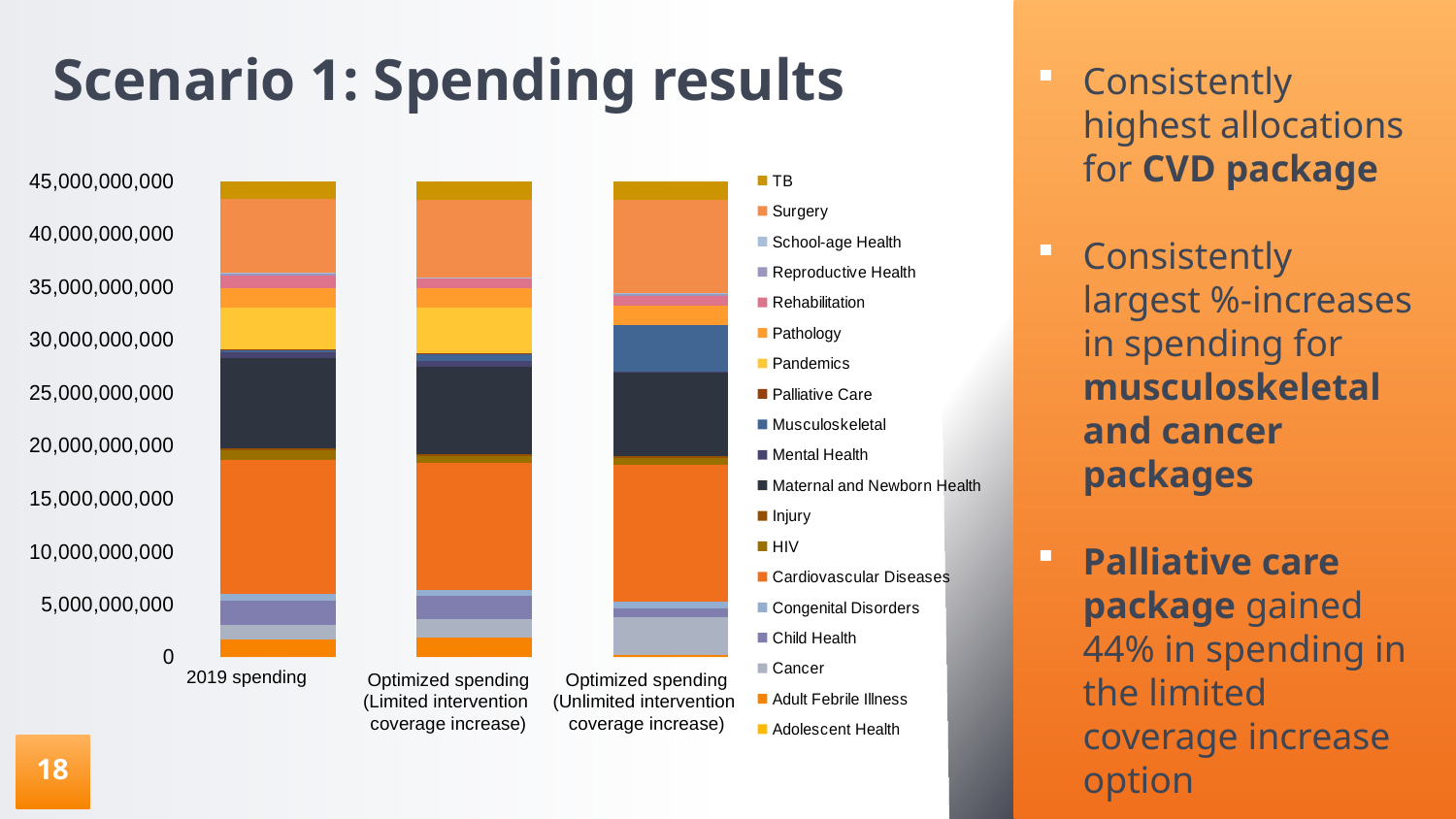
How many series does the chart legend list? 19 What kind of chart is shown on the slide? Stacked bar chart Which series occupies the largest segment in the 2019 spending bar? Cardiovascular Diseases How many bars (spending scenarios) are plotted on the chart? 3 Which series occupies the largest segment in the Optimized spending (Unlimited intervention coverage increase) bar? Cardiovascular Diseases What is the label of the first (leftmost) bar on the chart? 2019 spending What is the highest value shown on the vertical axis of the chart? 45,000,000,000 Is the Musculoskeletal segment larger in the 2019 spending bar or in the Optimized spending (Unlimited intervention coverage increase) bar? Optimized spending (Unlimited intervention coverage increase) Which series is listed first in the chart legend? TB Is the Cancer segment larger in the 2019 spending bar or in the Optimized spending (Unlimited intervention coverage increase) bar? Optimized spending (Unlimited intervention coverage increase)